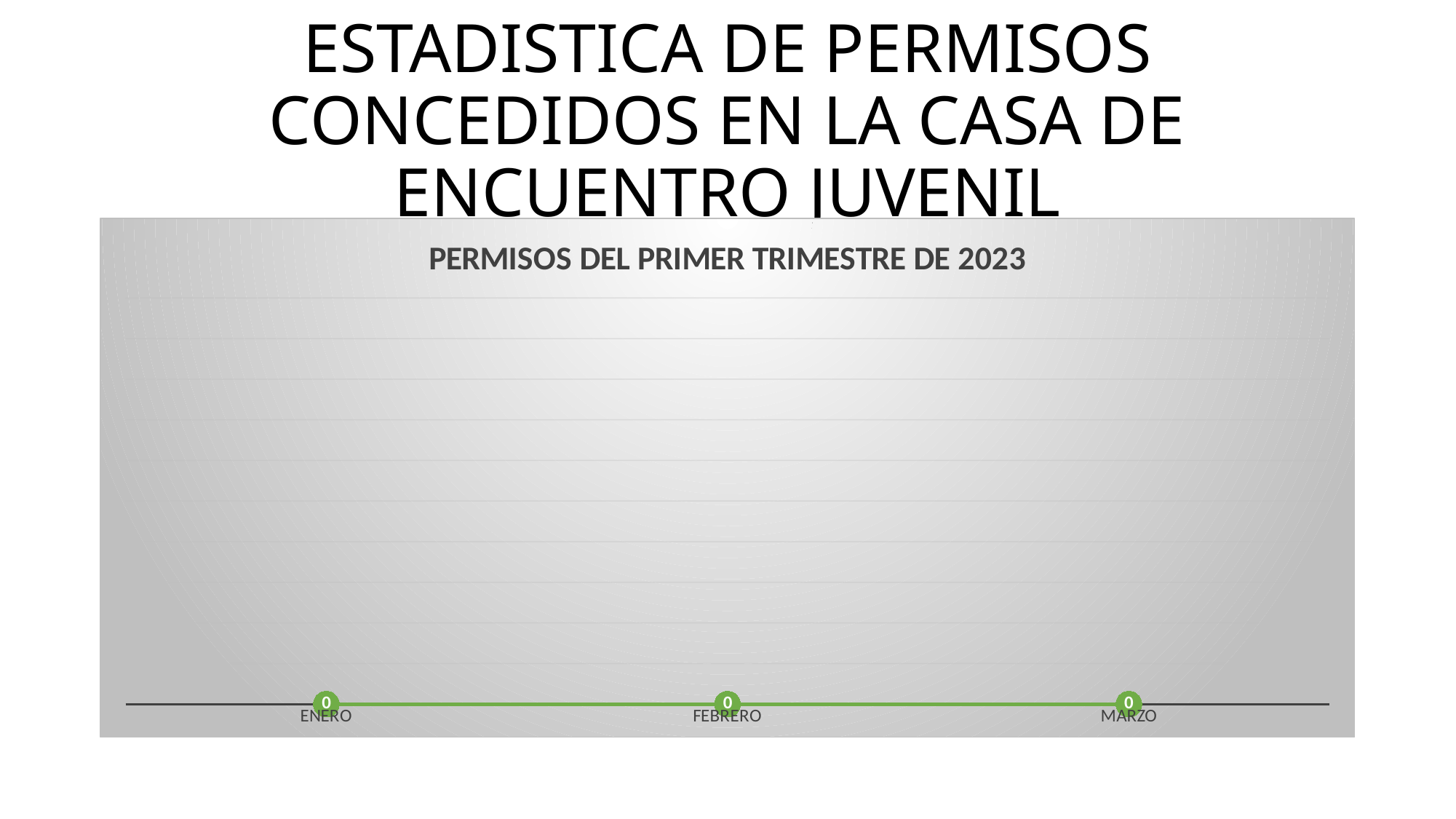
What is the value for ENERO? 0 What is the title of the chart? PERMISOS DEL PRIMER TRIMESTRE DE 2023 What kind of chart is shown on the slide? Line chart What is the value for FEBRERO? 0 What is the difference between the values for ENERO and MARZO? 0 How many categories are plotted on the x axis? 3 Do the values rise, fall or stay flat from ENERO to MARZO? Stay flat Which month is the first category on the x axis? ENERO What is the value for MARZO? 0 What is the total of the values for ENERO, FEBRERO and MARZO? 0